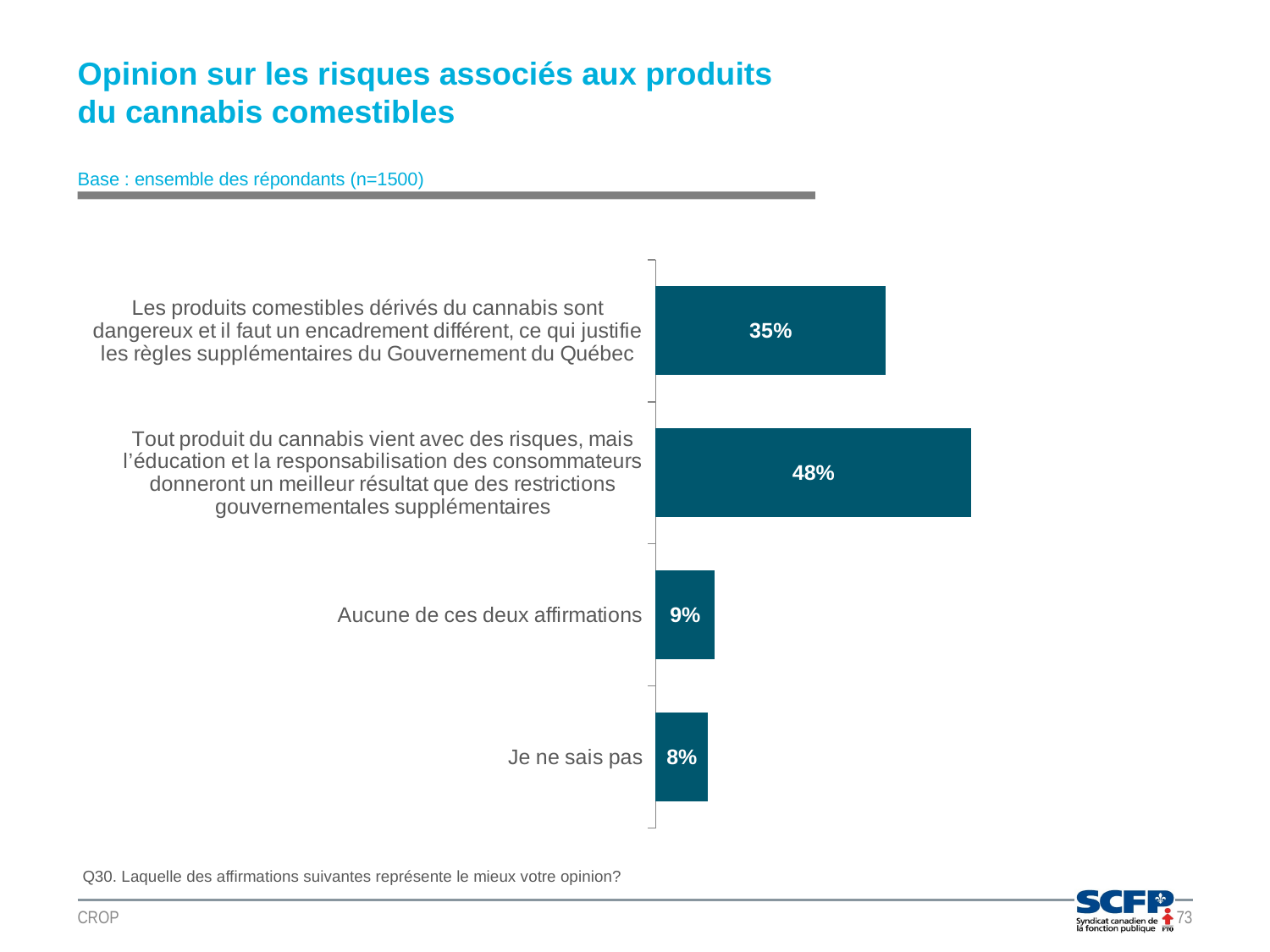
How many response categories are shown in the chart? 4 What percentage of respondents chose "Je ne sais pas"? 8% What is the difference in percentage points between the 48% statement and the 35% statement? 13 Which response option received the lowest percentage? Je ne sais pas Which statement received the highest share of respondents? Tout produit du cannabis vient avec des risques, mais l'éducation et la responsabilisation des consommateurs donneront un meilleur résultat que des restrictions gouvernementales supplémentaires What type of chart is shown on the slide? Bar chart What is the combined percentage of respondents who chose "Aucune de ces deux affirmations" or "Je ne sais pas"? 17% Which is larger: the share for "Aucune de ces deux affirmations" or the share for "Je ne sais pas"? Aucune de ces deux affirmations What is the base (number of respondents) stated for this chart? n=1500 What percentage of respondents chose "Aucune de ces deux affirmations"? 9% What percentage of respondents agreed that education and consumer responsibility will give better results than additional government restrictions? 48% What percentage of respondents agreed that edible cannabis products are dangerous and justify the additional rules of the Gouvernement du Québec? 35%